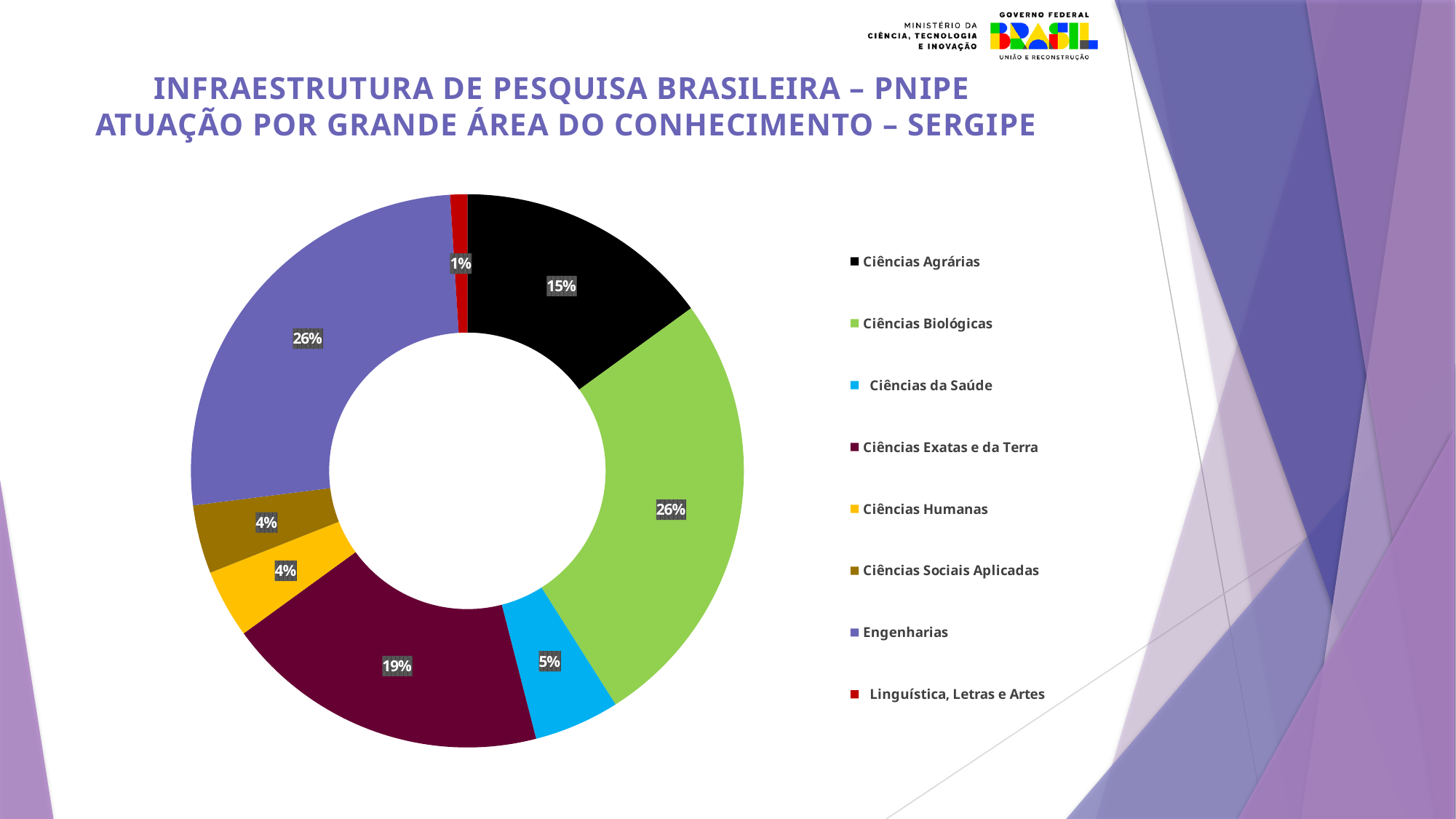
Which is larger, the share for Ciências da Saúde or the share for Ciências Humanas? Ciências da Saúde What kind of chart is shown on the slide? Doughnut (pie) chart Which category has the smallest share in the chart? Linguística, Letras e Artes What is the share shown for Ciências Exatas e da Terra? 19% What percentage does Ciências Agrárias account for in the chart? 15% What is the difference in percentage points between Ciências Exatas e da Terra and Ciências da Saúde? 14 What is the value shown for Engenharias? 26% Which is larger, the share for Ciências Exatas e da Terra or the share for Ciências Agrárias? Ciências Exatas e da Terra What colour represents Ciências Biológicas in the chart? Green How many categories does the legend list? 8 What is the difference in percentage points between Ciências Biológicas and Ciências Agrárias? 11 What percentage is shown for Ciências da Saúde? 5%